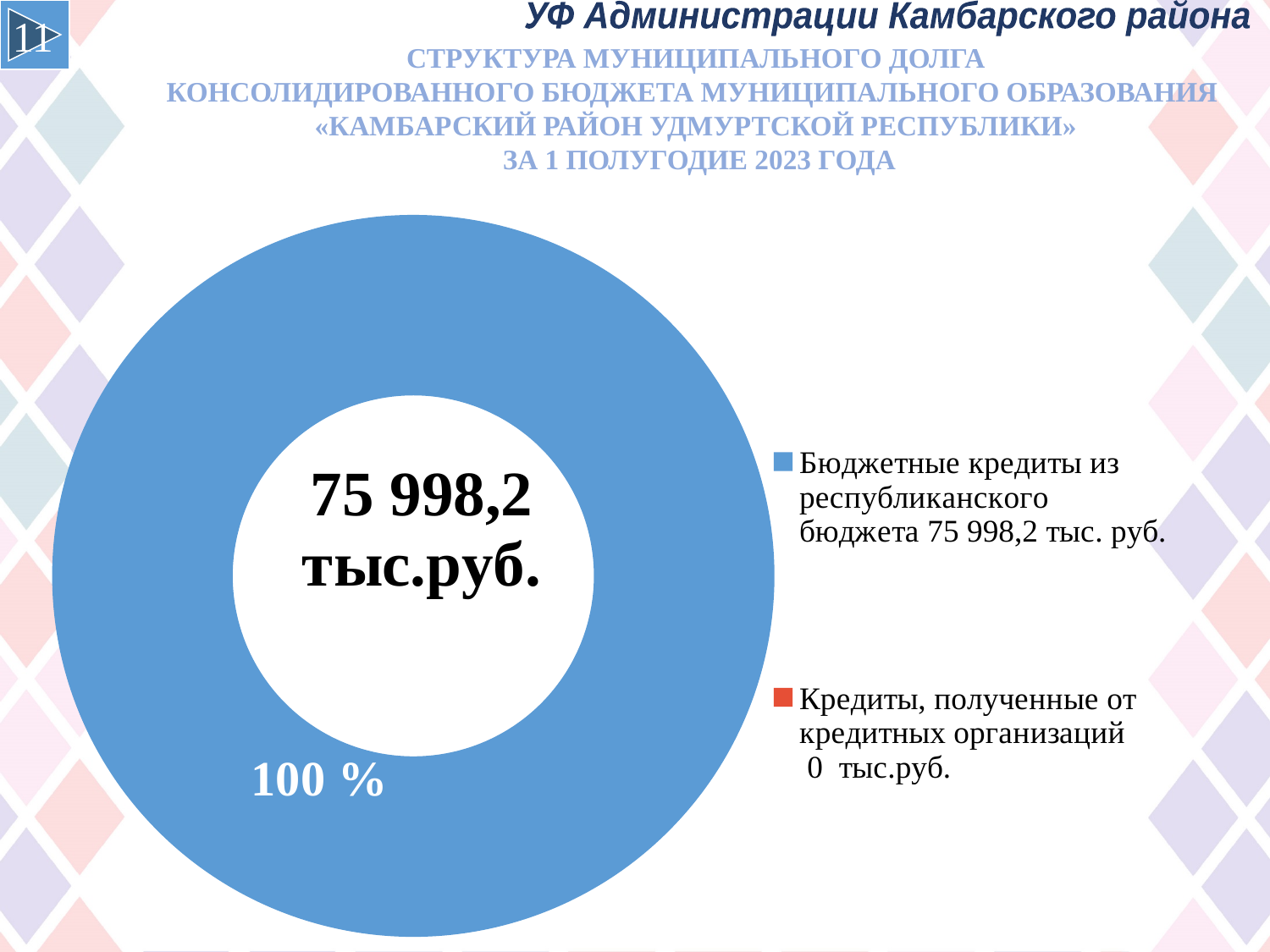
What colour is the slice for «Бюджетные кредиты из республиканского бюджета»? blue What value is given in the legend for «Кредиты, полученные от кредитных организаций»? 0 тыс.руб. Which is larger: the value for «Бюджетные кредиты из республиканского бюджета» or for «Кредиты, полученные от кредитных организаций»? Бюджетные кредиты из республиканского бюджета Which legend category has the largest value? Бюджетные кредиты из республиканского бюджета What colour does the legend assign to «Кредиты, полученные от кредитных организаций»? red (orange-red) What total value is printed in the centre of the doughnut chart? 75 998,2 тыс.руб. What kind of chart is shown on the slide? doughnut (pie) chart Which legend category has the smallest value? Кредиты, полученные от кредитных организаций What value is given in the legend for «Бюджетные кредиты из республиканского бюджета»? 75 998,2 тыс. руб. What is the difference between the value for «Бюджетные кредиты из республиканского бюджета» and the value for «Кредиты, полученные от кредитных организаций»? 75 998,2 тыс. руб. How many entries does the chart legend list? 2 What share of the chart does the slice for «Бюджетные кредиты из республиканского бюджета» take? 100 %